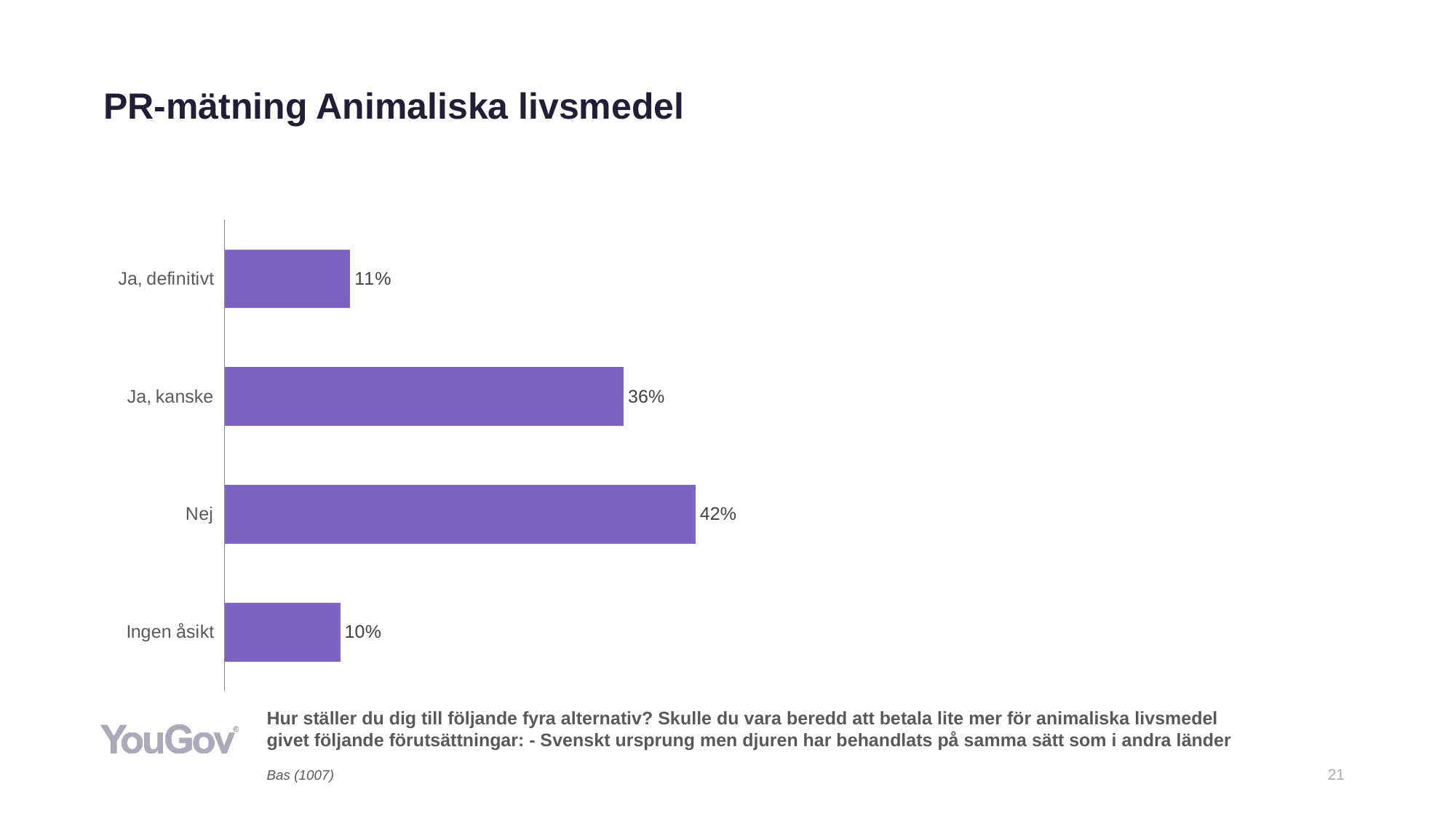
Which is larger, the value for "Ja, kanske" or the value for "Ja, definitivt"? Ja, kanske What is the title of the slide? PR-mätning Animaliska livsmedel What is the difference between the values for "Ja, kanske" and "Ja, definitivt"? 25% What is the value for "Ja, definitivt"? 11% What is the value for "Ingen åsikt"? 10% What is the difference between the values for "Nej" and "Ja, kanske"? 6% How many categories are shown in the chart? 4 Which category has the highest value? Nej What is the value for "Nej"? 42% What kind of chart is shown on the slide? Bar chart Which category has the lowest value? Ingen åsikt What is the value for "Ja, kanske"? 36%